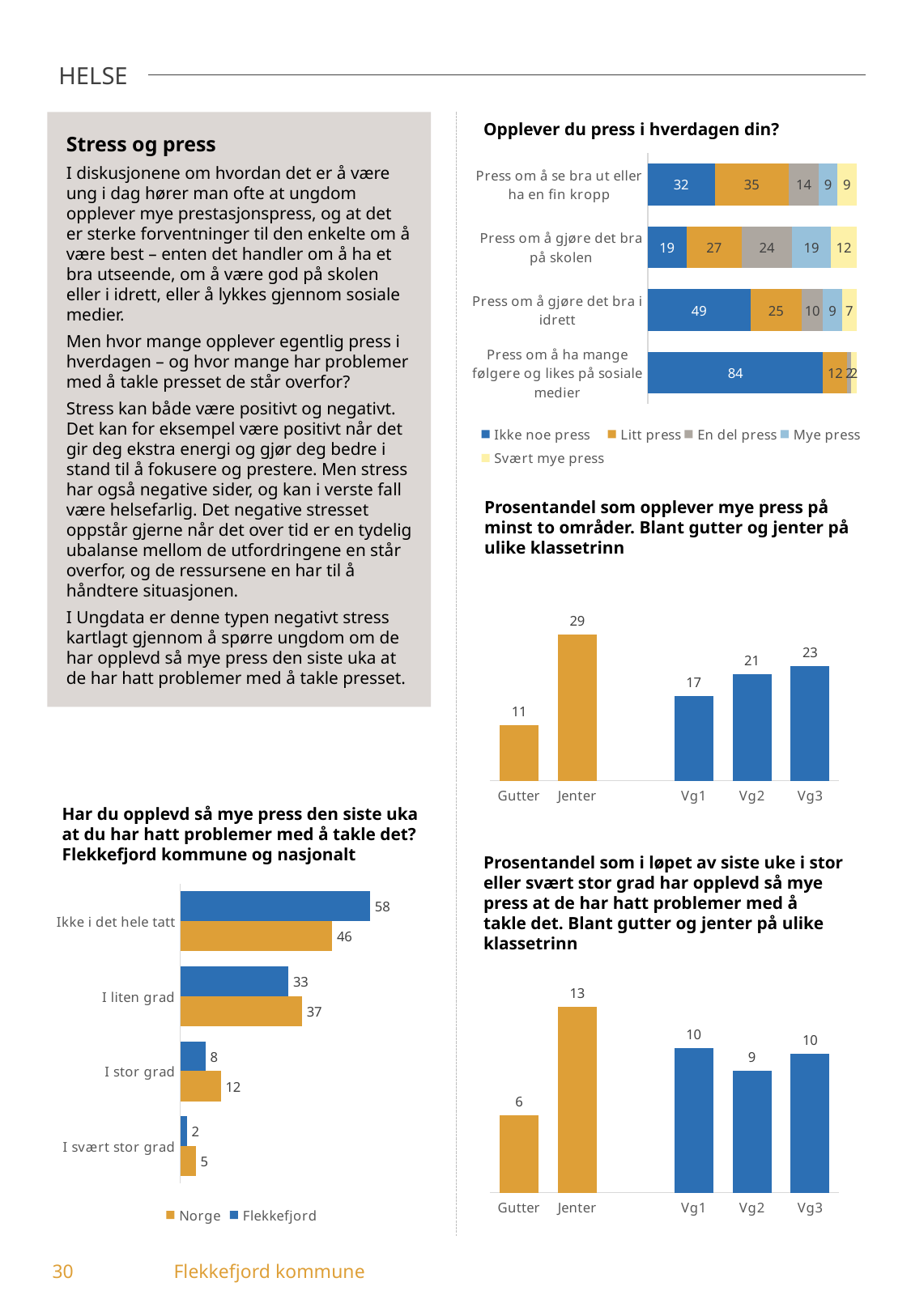
In the chart 'Prosentandel som opplever mye press på minst to områder', what is the difference between Jenter and Gutter? 18 In the chart 'Har du opplevd så mye press den siste uka at du har hatt problemer med å takle det?', which is larger for 'I liten grad': Norge or Flekkefjord? Norge In the chart 'Opplever du press i hverdagen din?', what is the total of the stacked bar for 'Press om å gjøre det bra i idrett'? 100 In the chart 'Prosentandel som opplever mye press på minst to områder', what is the value for Vg2? 21 In the bottom-right chart 'Prosentandel som i løpet av siste uke i stor eller svært stor grad har opplevd så mye press...', which category has the lowest value? Gutter In the chart 'Opplever du press i hverdagen din?', what is the value for 'Ikke noe press' for 'Press om å ha mange følgere og likes på sosiale medier'? 84 In the chart 'Opplever du press i hverdagen din?', what is the value for 'Litt press' for 'Press om å gjøre det bra på skolen'? 27 How many series does the legend of the chart 'Opplever du press i hverdagen din?' list? 5 In the chart 'Prosentandel som opplever mye press på minst to områder', which category has the highest value? Jenter In the bottom-right chart 'Prosentandel som i løpet av siste uke i stor eller svært stor grad har opplevd så mye press...', what is the value for Vg2? 9 What kind of chart is 'Har du opplevd så mye press den siste uka at du har hatt problemer med å takle det?'? Bar chart In the chart 'Har du opplevd så mye press den siste uka at du har hatt problemer med å takle det?', what is the value for Flekkefjord for 'Ikke i det hele tatt'? 58